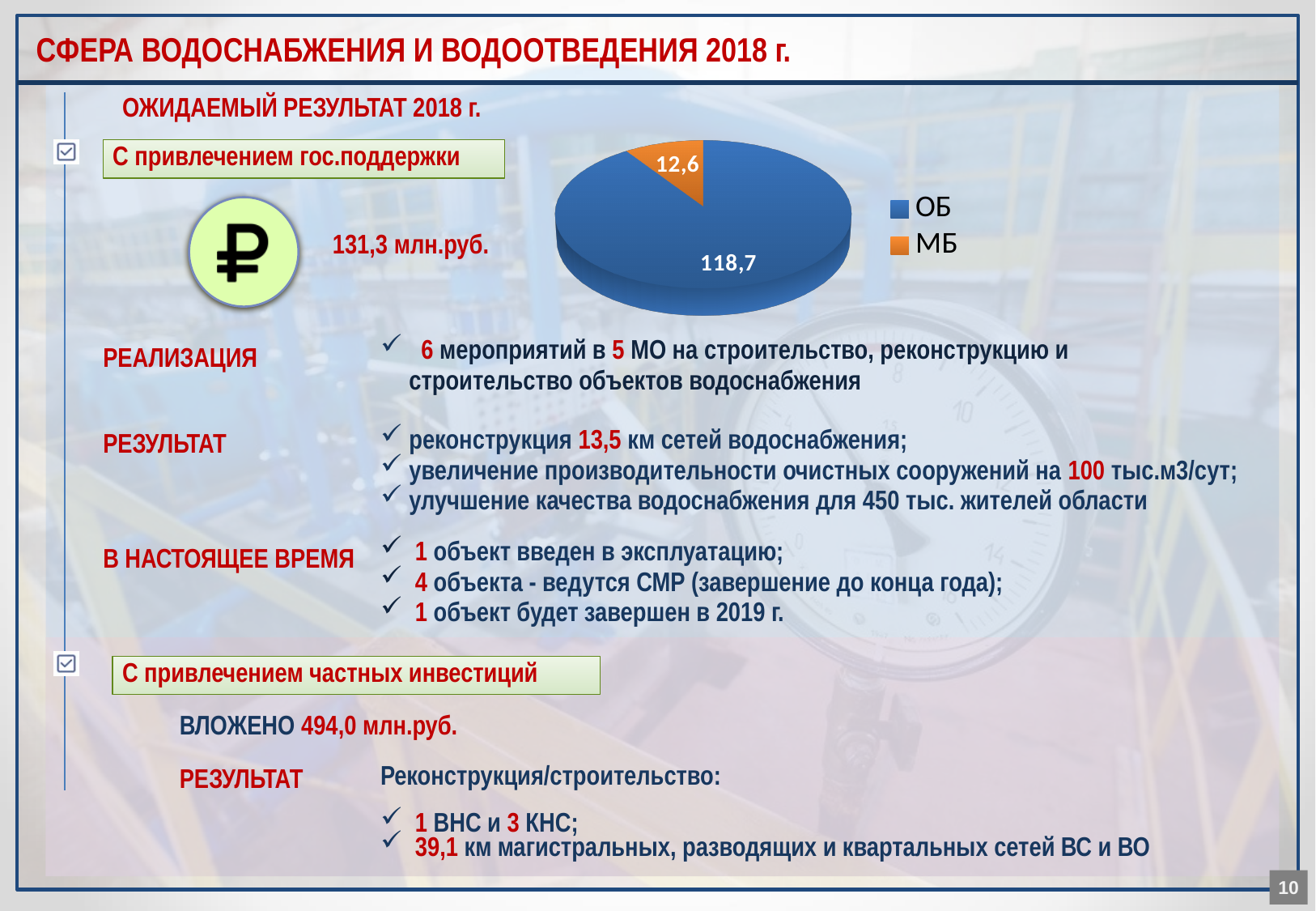
What is the total of the two slices in the pie chart? 131,3 What share of the pie chart does the МБ slice represent? 9,6% Which slice of the pie chart is the smallest? МБ Which slice of the pie chart is the largest? ОБ Which is larger in the pie chart, ОБ or МБ? ОБ What is the value of the ОБ slice in the pie chart? 118,7 How many slices does the pie chart have? 2 What kind of chart is shown on the slide? Pie chart What is the difference between the ОБ and МБ values in the pie chart? 106,1 What is the value of the МБ slice in the pie chart? 12,6 How many entries does the pie chart legend list? 2 What colour is the ОБ slice in the pie chart? Blue